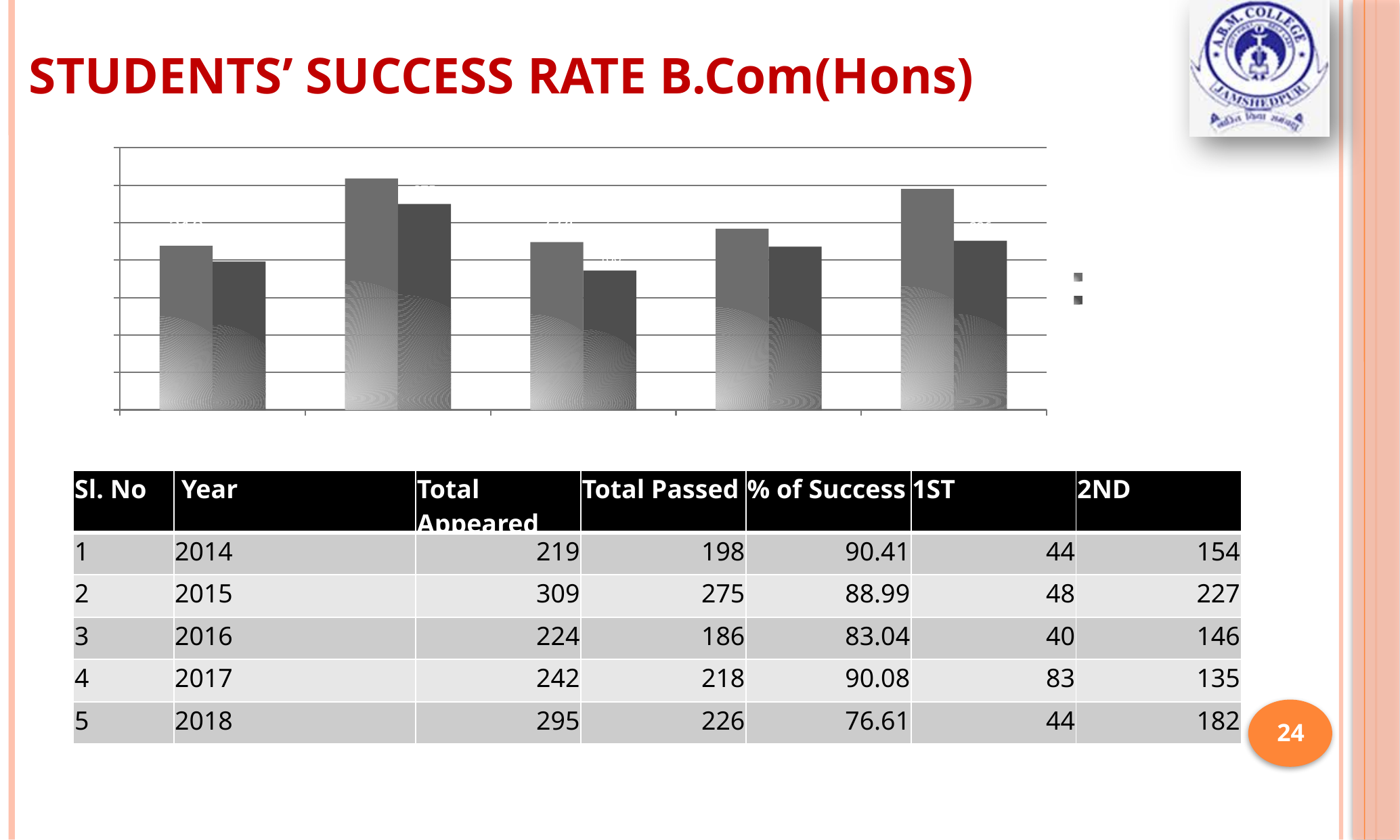
How many groups of bars does the chart show? 5 Which group of bars, counted from the left, contains the tallest bar in the chart? the second group In each group of the chart, is the left (lighter) bar taller or shorter than the right (darker) bar? taller How many bars are there in each group of the chart? 2 Is the lighter bar in the second group from the left taller or shorter than the lighter bar in the fifth group? taller Which group of bars, counted from the left, contains the shortest bar in the chart? the third group Is the darker bar in the third group from the left taller or shorter than the darker bar in the second group? shorter What kind of chart is shown on the slide? bar chart